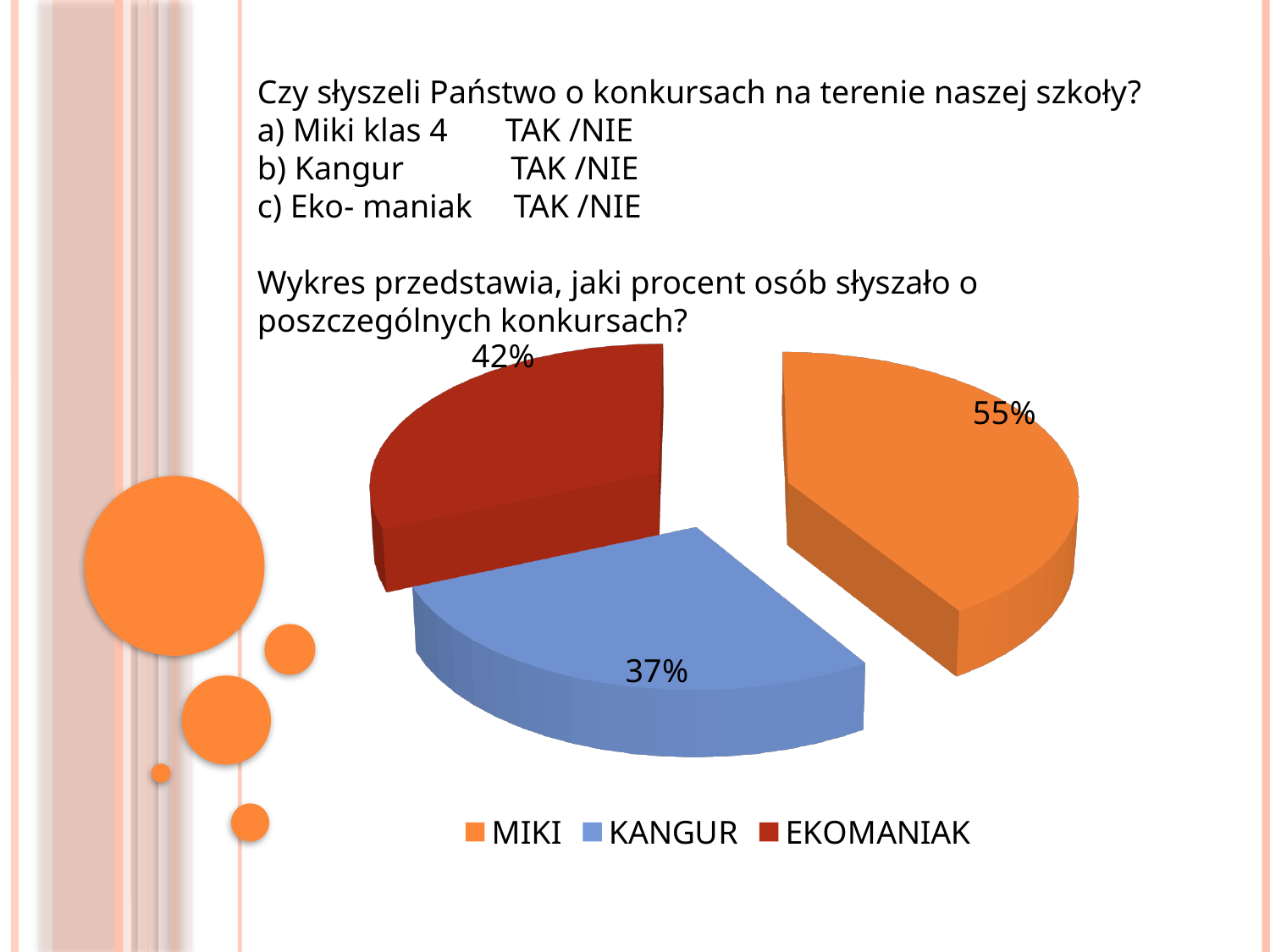
Which category has the highest value? MIKI What value is shown for MIKI? 55% What value is shown for KANGUR? 37% How many entries does the legend list? 3 How many slices does the pie chart have? 3 What colour is the KANGUR slice? blue Which category has the lowest value? KANGUR Which is larger, the value for EKOMANIAK or the value for KANGUR? EKOMANIAK What is the difference between the values for MIKI and KANGUR? 18% What value is shown for EKOMANIAK? 42% What kind of chart is shown on the slide? pie chart What is the difference between the values for EKOMANIAK and KANGUR? 5%